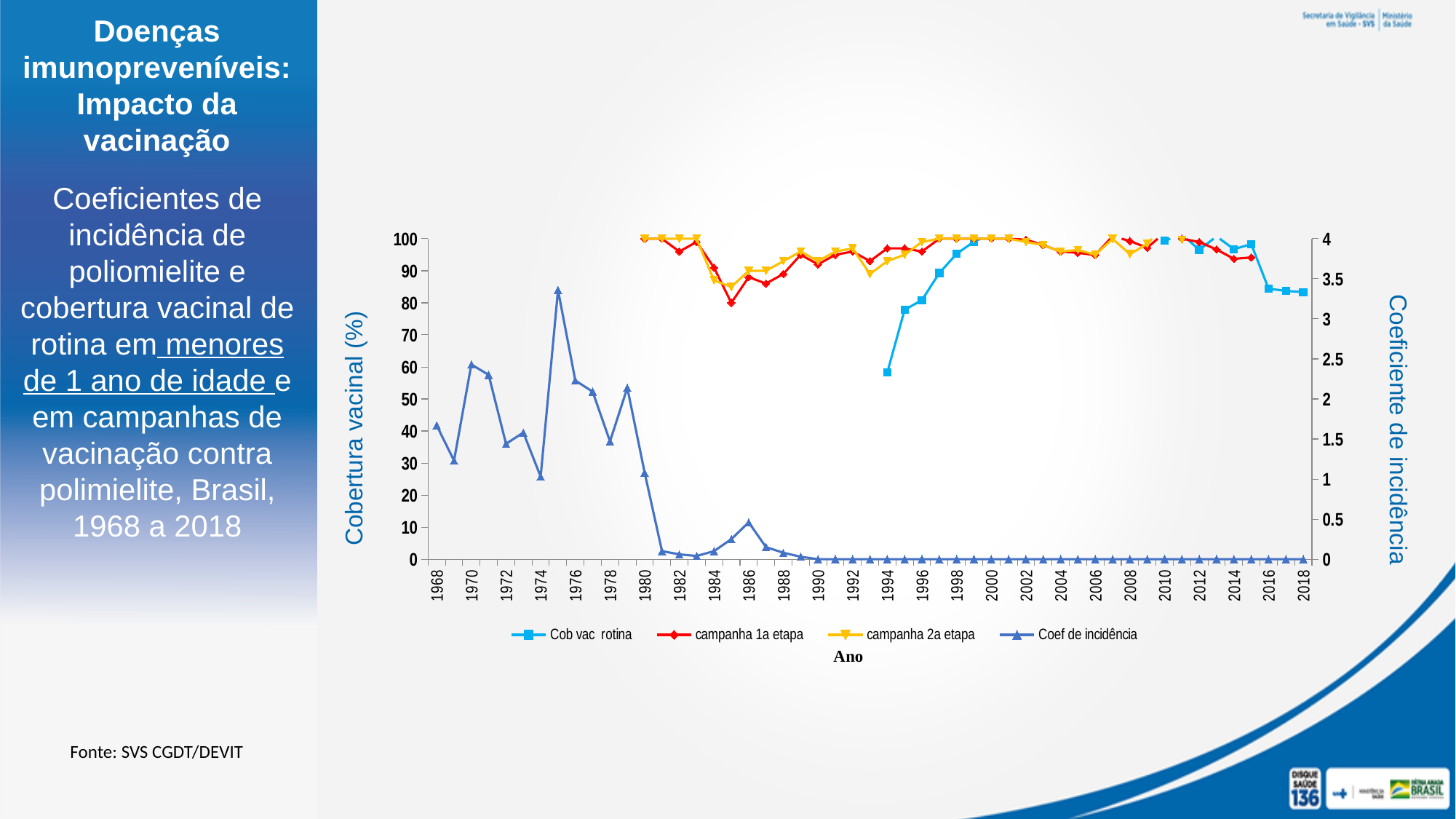
What is the title of the left vertical axis of the chart? Cobertura vacinal (%) Is the campanha 1a etapa value for 1985 greater or less than 90? less Is the Cob vac rotina value for 2018 greater or less than 90? less How many series does the chart legend list? 4 What are the four series listed in the chart legend? Cob vac rotina, campanha 1a etapa, campanha 2a etapa, Coef de incidência Is the Cob vac rotina value for 1994 greater or less than 50? greater Does the Cob vac rotina series rise or fall between 1994 and 1999? rise In which year does the Coef de incidência series reach its highest value? 1975 Which is larger for Cob vac rotina: the value in 1994 or the value in 1998? 1998 Does the Coef de incidência series generally rise or fall from 1968 to 2018? fall What kind of chart is shown on the slide? line chart